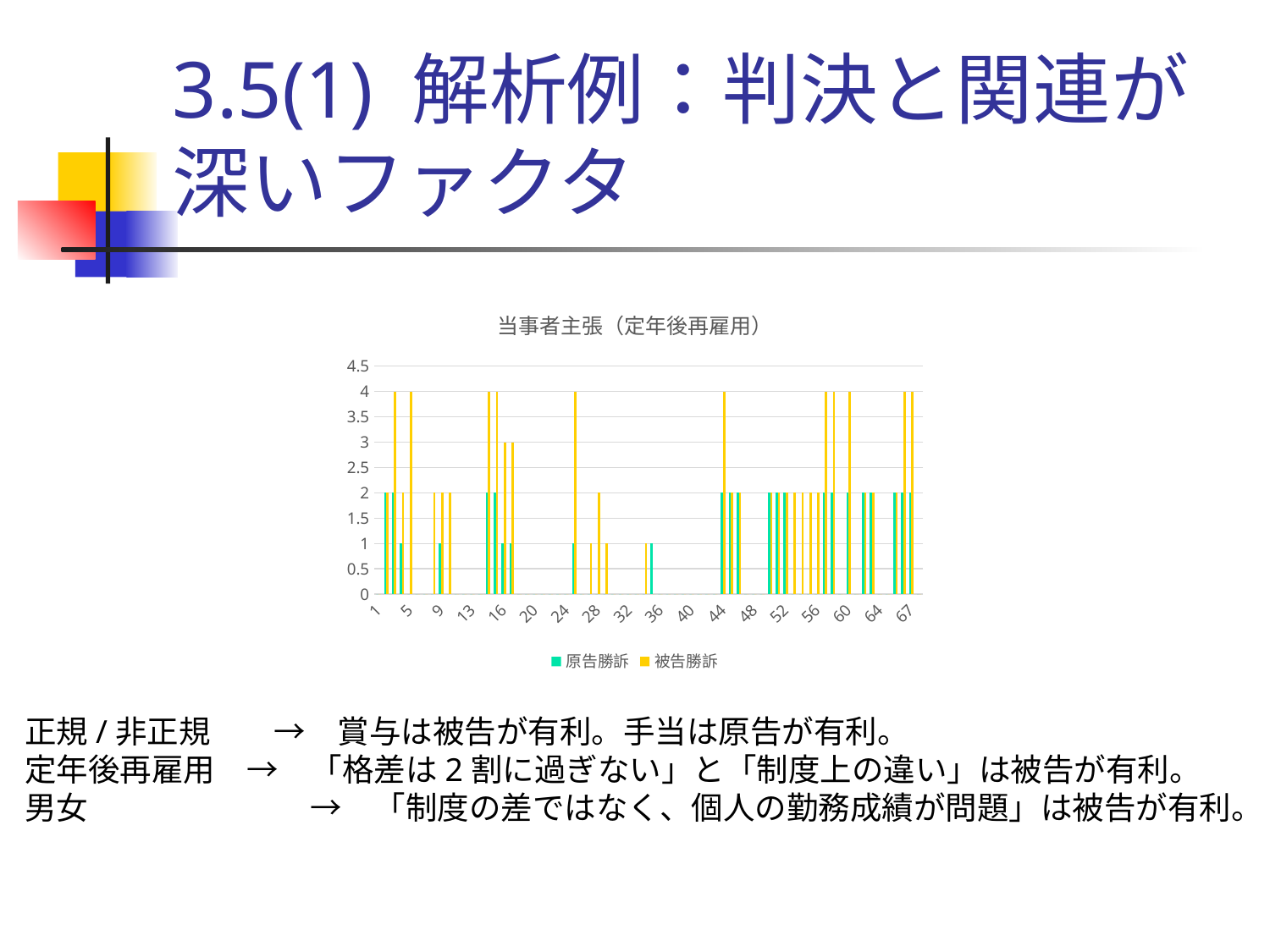
What is the interval between consecutive tick marks on the y axis? 0.5 What is the highest value reached by any 原告勝訴 bar? 2 What is the title of the chart? 当事者主張（定年後再雇用） Is the tallest bar in the chart greater or less than 4.5? less What is the highest value reached by any bar in the chart? 4 Which series reaches the higher maximum value, 原告勝訴 or 被告勝訴? 被告勝訴 What is the last tick label on the chart's x axis? 67 What are the two series named in the chart legend? 原告勝訴, 被告勝訴 How many series does the chart legend list? 2 What kind of chart is shown on the slide? bar chart What is the highest value shown on the chart's y axis? 4.5